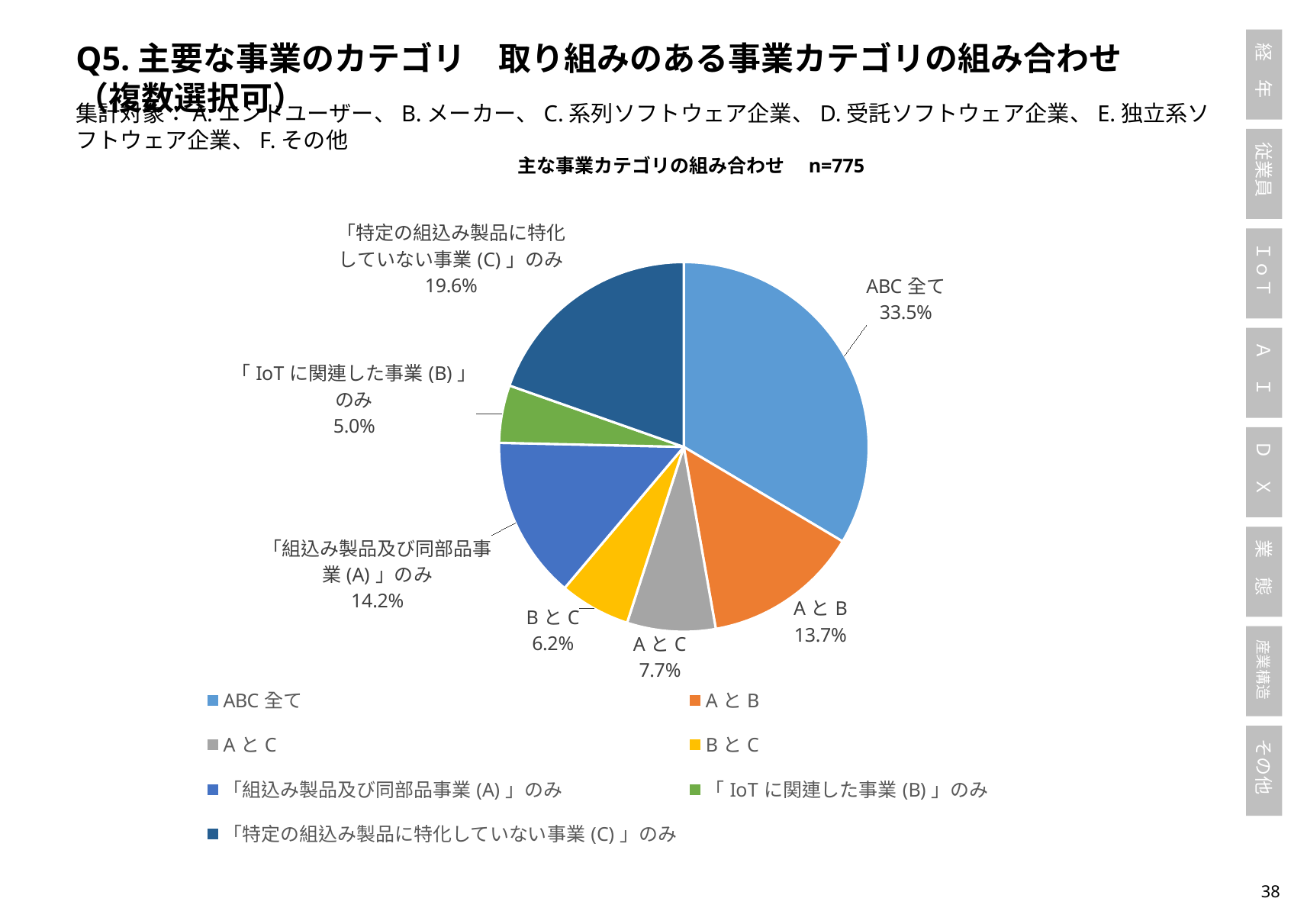
What is the share for B と C? 6.2% What is the share for A と B? 13.7% Which category has the smallest slice? 「 IoT に関連した事業 (B) 」のみ What is the difference between the shares for ABC 全て and 「特定の組込み製品に特化していない事業 (C) 」のみ? 13.9% What is the sample size (n) shown in the chart title? n=775 Which category has the largest slice? ABC 全て What is the share for 「特定の組込み製品に特化していない事業 (C) 」のみ? 19.6% Which is larger, the share for A と C or the share for B と C? A と C How many slices does the pie chart have? 7 What type of chart is shown on the slide? pie chart What colour is the slice for A と B? orange What is the share for ABC 全て? 33.5%